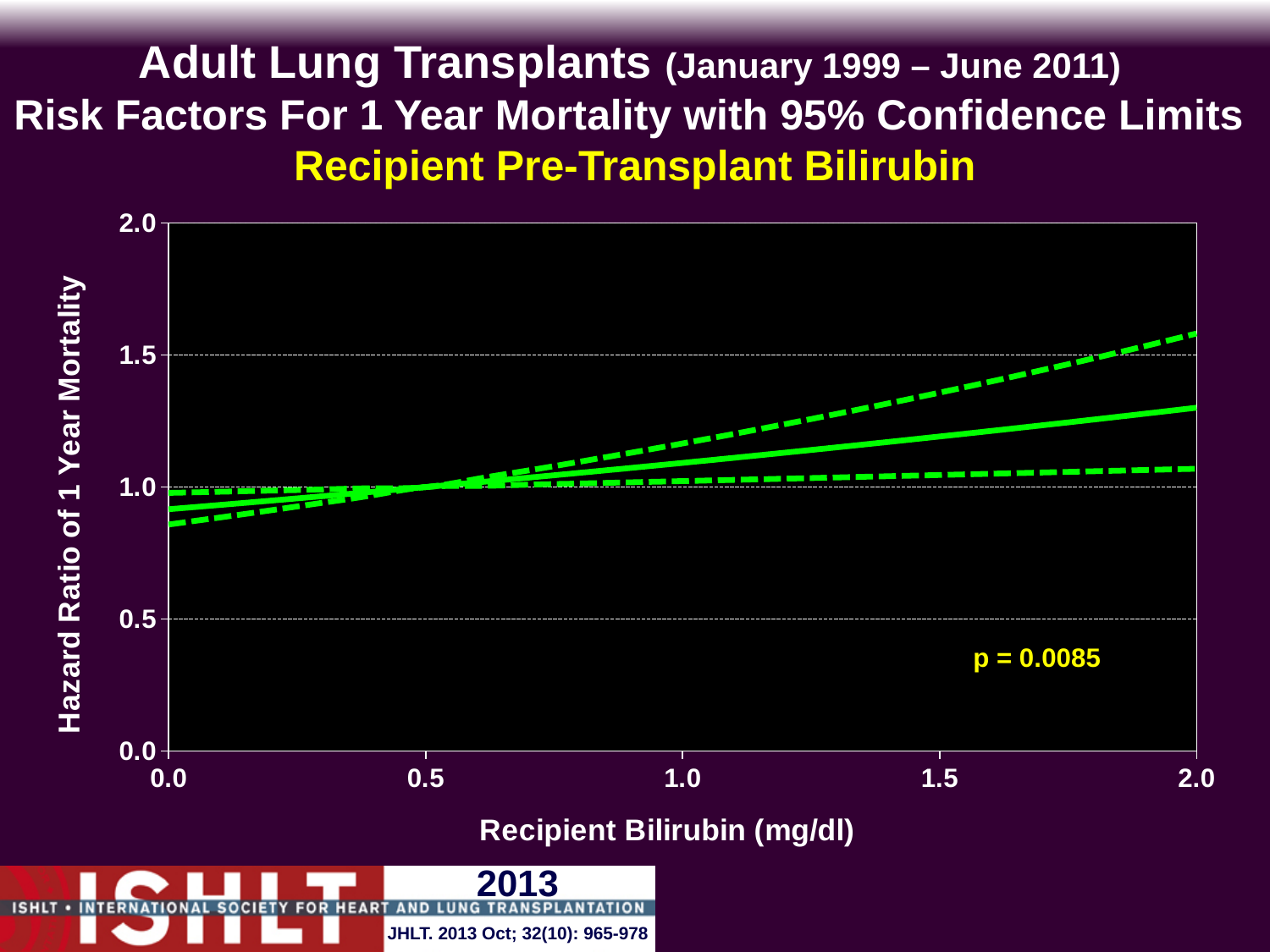
Is the solid hazard ratio line at a recipient bilirubin of 2.0 mg/dl greater or less than 1.5? less Is the upper dashed confidence limit at a recipient bilirubin of 1.0 mg/dl greater or less than 1.0? greater Does the upper dashed confidence limit rise or fall along the x axis? rise How many lines are plotted on the chart? 3 Is the lower dashed confidence limit at a recipient bilirubin of 0.0 mg/dl greater or less than 1.0? less Does the solid hazard ratio line rise or fall as recipient bilirubin increases from 0.0 to 2.0 mg/dl? rise What is the label of the x axis? Recipient Bilirubin (mg/dl) What p-value is printed on the chart? p = 0.0085 What kind of chart is shown on the slide? line chart